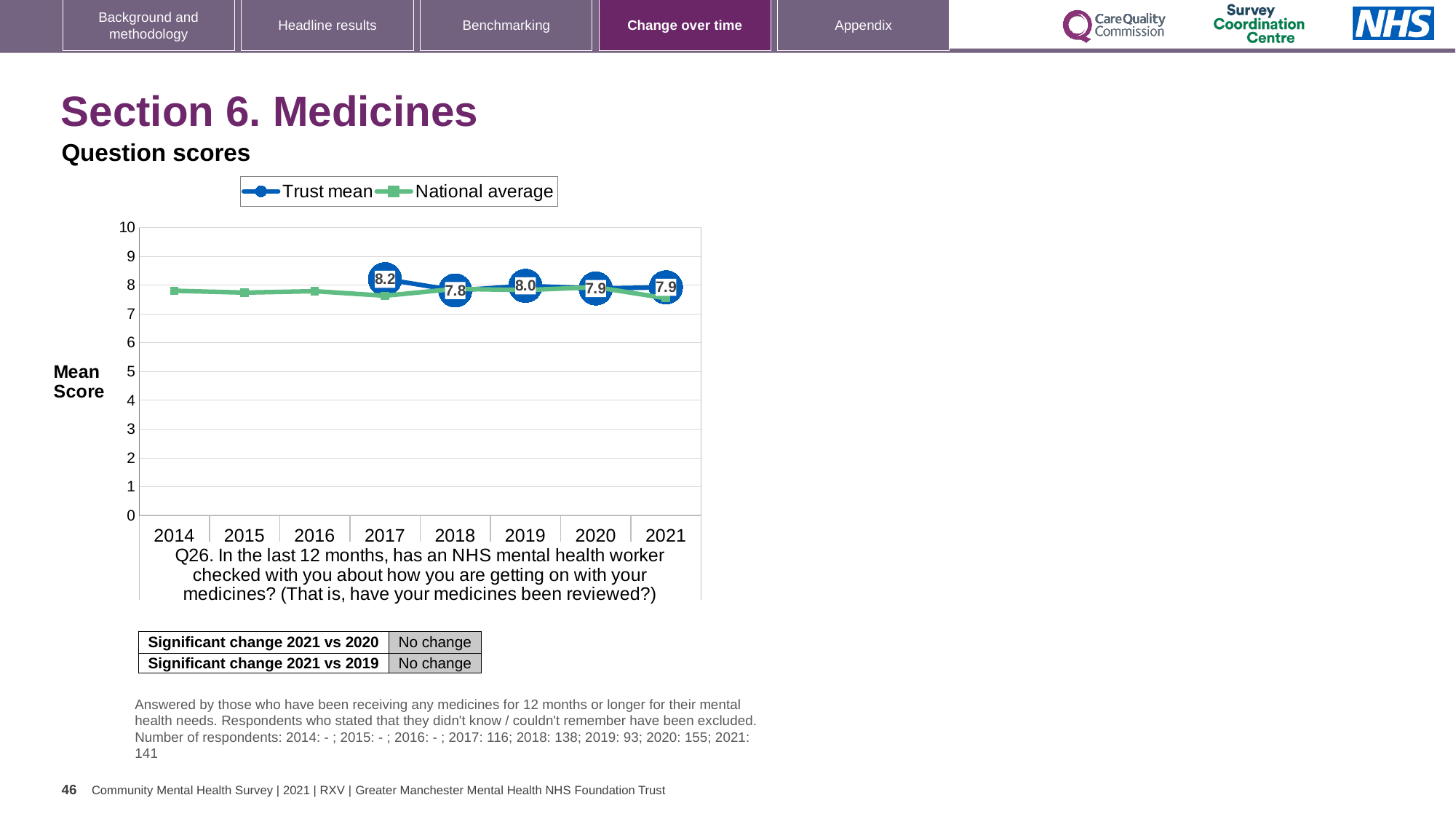
In which year is the Trust mean score highest? 2017 Which year has the larger Trust mean score, 2017 or 2019? 2017 What kind of chart is shown on the slide? Line chart What is the Trust mean score for 2021? 7.9 What is the difference between the Trust mean scores for 2017 and 2018? 0.4 How many years are shown on the x axis of the chart? 8 What is the Trust mean score for 2018? 7.8 Does the Trust mean score rise or fall from 2017 to 2018? Fall What is the Trust mean score for 2017? 8.2 How many series does the chart legend list? 2 Is the National average value for 2014 greater or less than 7? greater In which year is the Trust mean score lowest? 2018